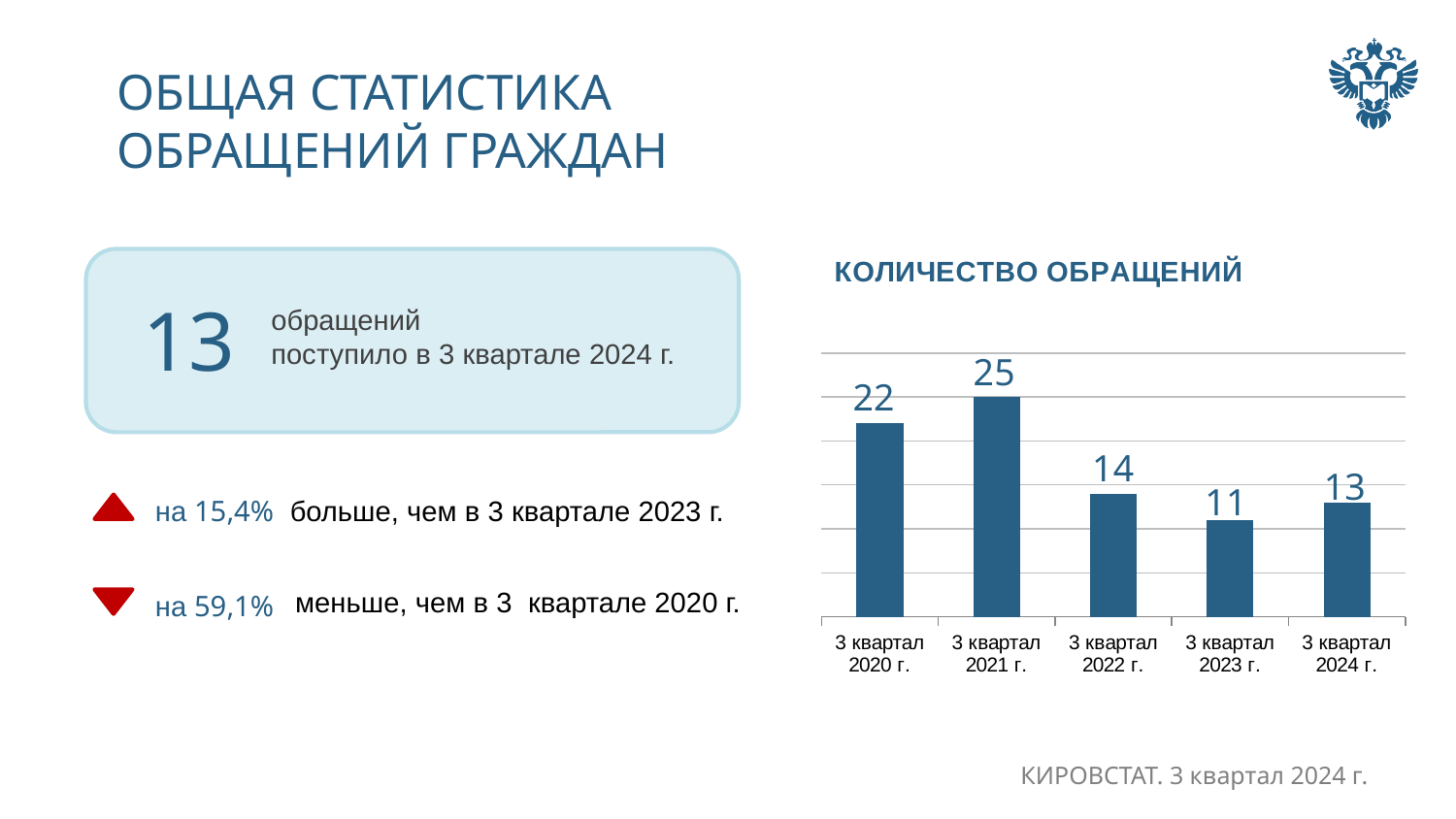
What is the value for 3 квартал 2020 г. in the chart? 22 Which is larger, the value for 3 квартал 2022 г. or the value for 3 квартал 2024 г.? 3 квартал 2022 г. What is the difference between the values for 3 квартал 2021 г. and 3 квартал 2024 г.? 12 What is the value for 3 квартал 2021 г. in the chart? 25 What kind of chart is shown on the slide? bar chart How many categories are shown in the chart? 5 What is the title of the chart? КОЛИЧЕСТВО ОБРАЩЕНИЙ What is the value for 3 квартал 2023 г. in the chart? 11 Do the values rise or fall from 3 квартал 2021 г. to 3 квартал 2023 г.? fall Which category has the highest value in the chart? 3 квартал 2021 г. Which category has the lowest value in the chart? 3 квартал 2023 г. What is the difference between the values for 3 квартал 2020 г. and 3 квартал 2022 г.? 8